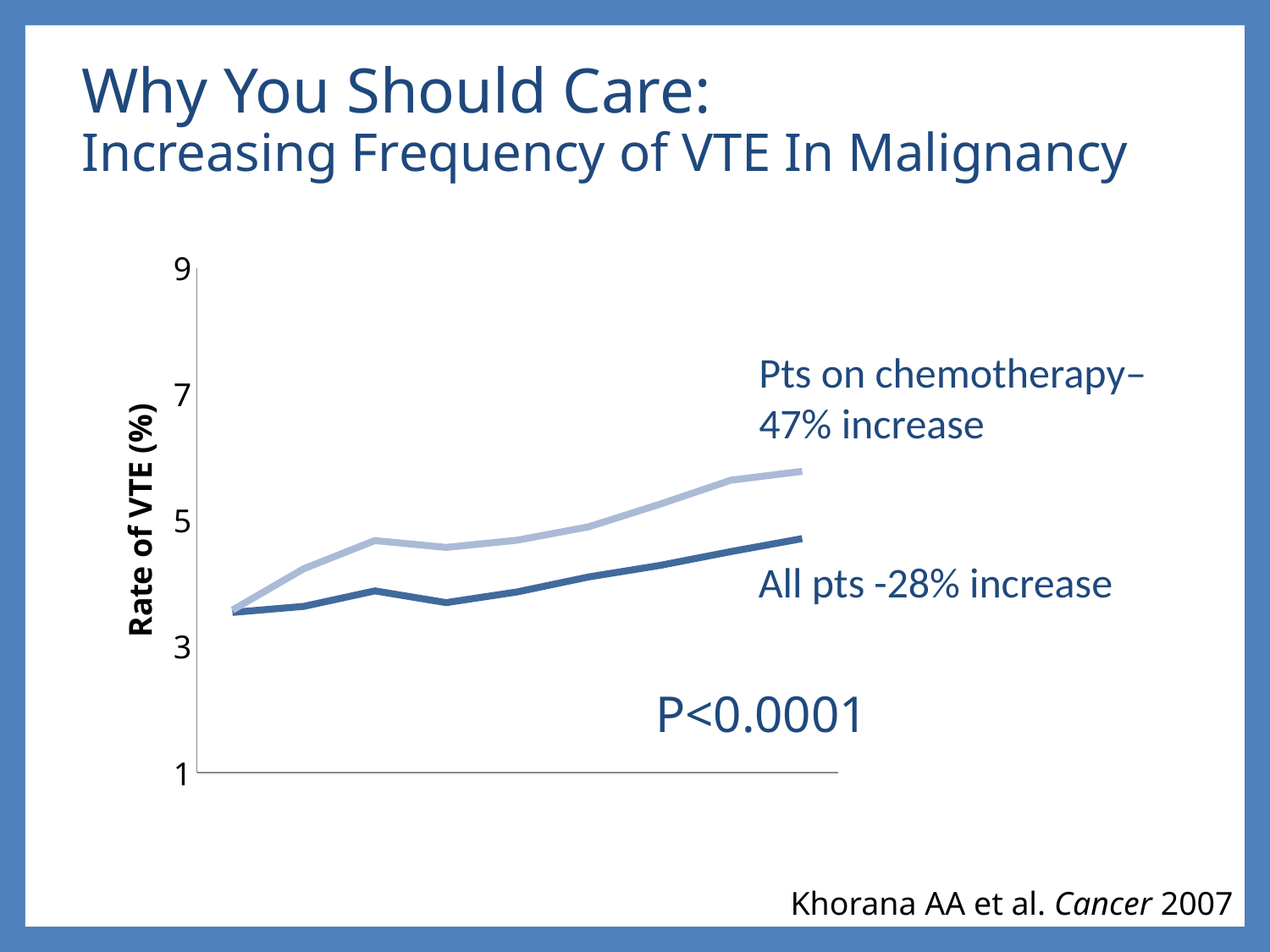
Which group shows the larger percentage increase according to the annotations: Pts on chemotherapy or All pts? Pts on chemotherapy Is the starting value of the Pts on chemotherapy line greater or less than 5? less Is the final value of the Pts on chemotherapy line greater or less than 5? greater Is the starting value of the All pts line greater or less than 3? greater What percentage increase is annotated for patients on chemotherapy? 47% increase Does the rate of VTE for patients on chemotherapy rise or fall along the x axis overall? Rise What is the label of the y axis? Rate of VTE (%) Does the rate of VTE for all patients rise or fall along the x axis overall? Rise How many lines (series) are plotted on the chart? 2 What kind of chart is shown on the slide? Line chart At the right end of the chart, which line is higher: Pts on chemotherapy or All pts? Pts on chemotherapy